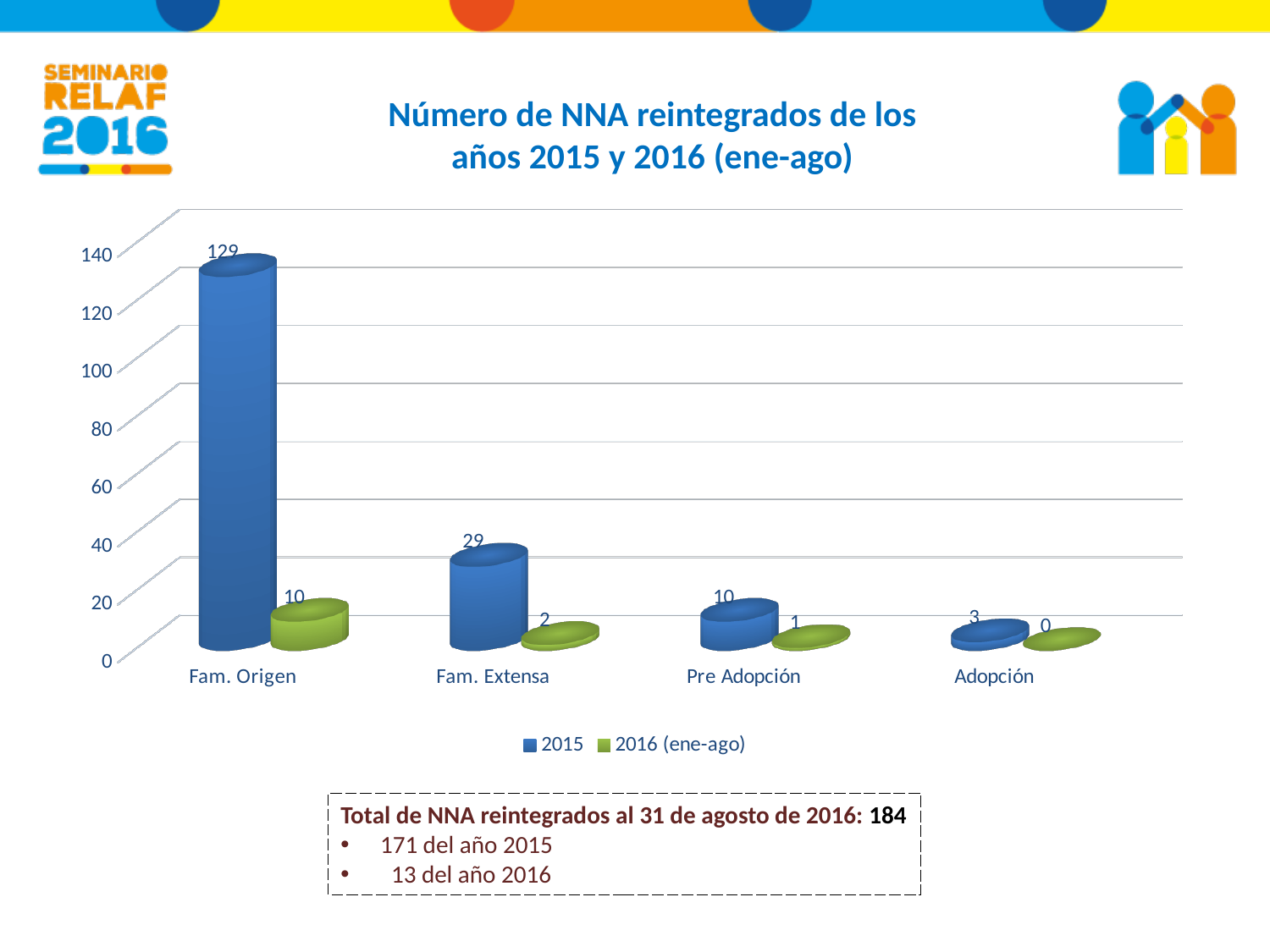
What is the value for Pre Adopción in the 2015 series? 10 Do the 2015 values rise or fall from Fam. Origen to Adopción along the x axis? Fall What kind of chart is shown on the slide? Bar chart How many categories are shown on the x axis? 4 Which category has the highest value in the 2015 series? Fam. Origen What is the value for Adopción in the 2016 (ene-ago) series? 0 Which is larger: the 2015 value for Fam. Extensa or the 2015 value for Pre Adopción? Fam. Extensa How many series does the legend list? 2 Which category has the lowest value in the 2016 (ene-ago) series? Adopción What is the value for Fam. Extensa in the 2016 (ene-ago) series? 2 What is the difference between the 2015 and 2016 (ene-ago) values for Fam. Origen? 119 What is the value for Fam. Origen in the 2015 series? 129